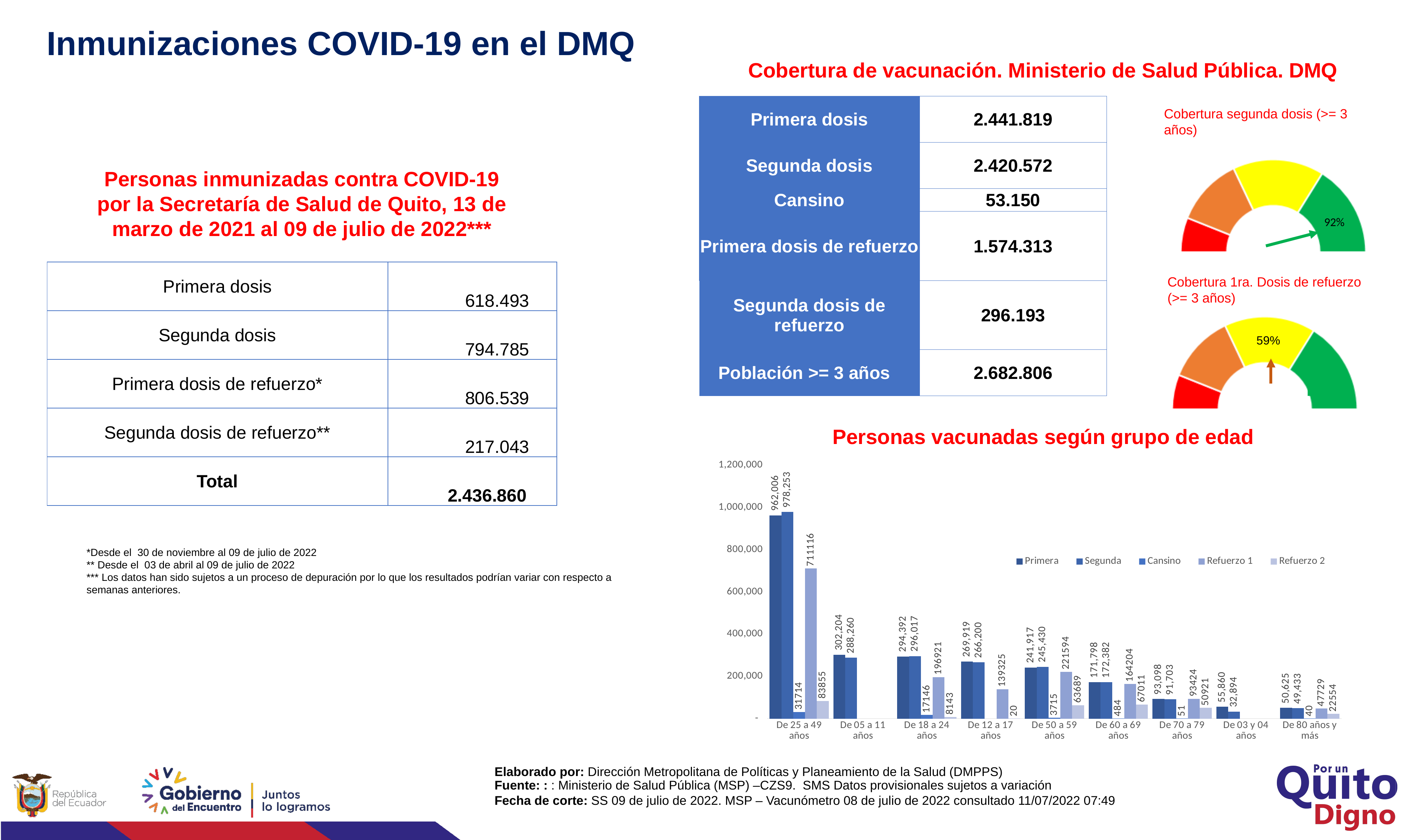
In the chart 'Personas vacunadas según grupo de edad', what is the Segunda value for 'De 05 a 11 años'? 288,260 In the chart 'Personas vacunadas según grupo de edad', which age group has the highest Segunda value? De 25 a 49 años In the chart 'Personas vacunadas según grupo de edad', how many series does the legend list? 5 In the chart 'Personas vacunadas según grupo de edad', is the Refuerzo 1 value for 'De 25 a 49 años' greater or less than 600,000? greater In the chart 'Personas vacunadas según grupo de edad', what is the difference between the Segunda and Primera values for 'De 25 a 49 años'? 16,247 In the chart 'Personas vacunadas según grupo de edad', what is the Primera value for 'De 25 a 49 años'? 962,006 In the chart 'Personas vacunadas según grupo de edad', what is the Refuerzo 1 value for 'De 50 a 59 años'? 221594 In the gauge chart 'Cobertura segunda dosis (>= 3 años)', what percentage is shown? 92% In the chart 'Personas vacunadas según grupo de edad', which is larger for 'De 18 a 24 años': Refuerzo 1 or Refuerzo 2? Refuerzo 1 In the chart 'Personas vacunadas según grupo de edad', what kind of chart is shown? bar chart In the chart 'Personas vacunadas según grupo de edad', how many age groups are shown on the x axis? 9 In the chart 'Personas vacunadas según grupo de edad', which age group has the lowest Primera value? De 80 años y más